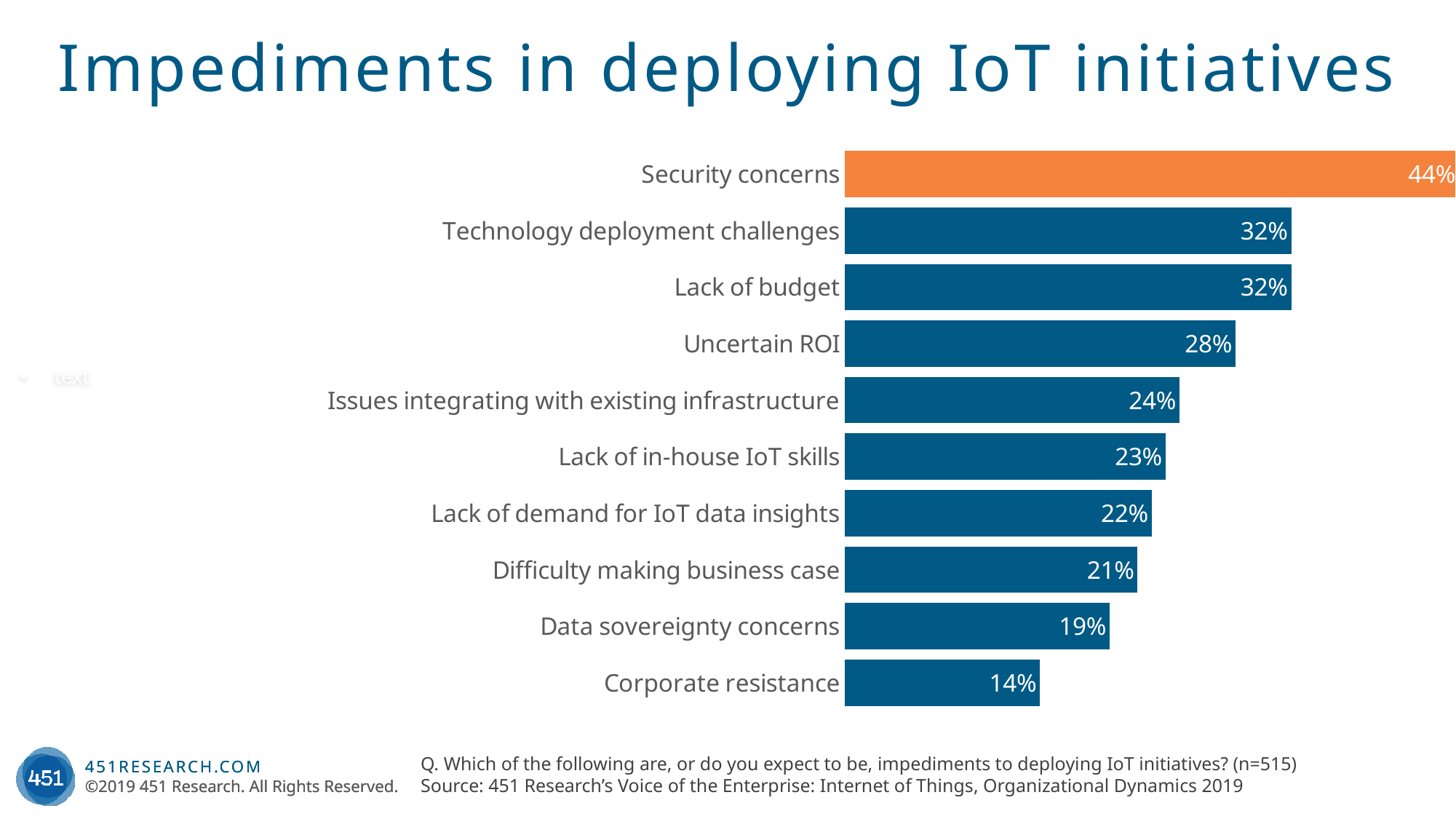
What is the difference between the values for Issues integrating with existing infrastructure and Data sovereignty concerns? 5 percentage points What percentage of respondents cited security concerns as an impediment to deploying IoT initiatives? 44% Which bar is coloured orange rather than blue? Security concerns What kind of chart is shown on the slide? Bar chart What is the difference between the values for Security concerns and Technology deployment challenges? 12 percentage points What is the value for Corporate resistance? 14% How many impediments are shown in the chart? 10 What is the value for Uncertain ROI? 28% What is the value for Lack of in-house IoT skills? 23% Which impediment has the lowest percentage? Corporate resistance Which is larger, the value for Lack of demand for IoT data insights or the value for Difficulty making business case? Lack of demand for IoT data insights Which impediment has the highest percentage? Security concerns